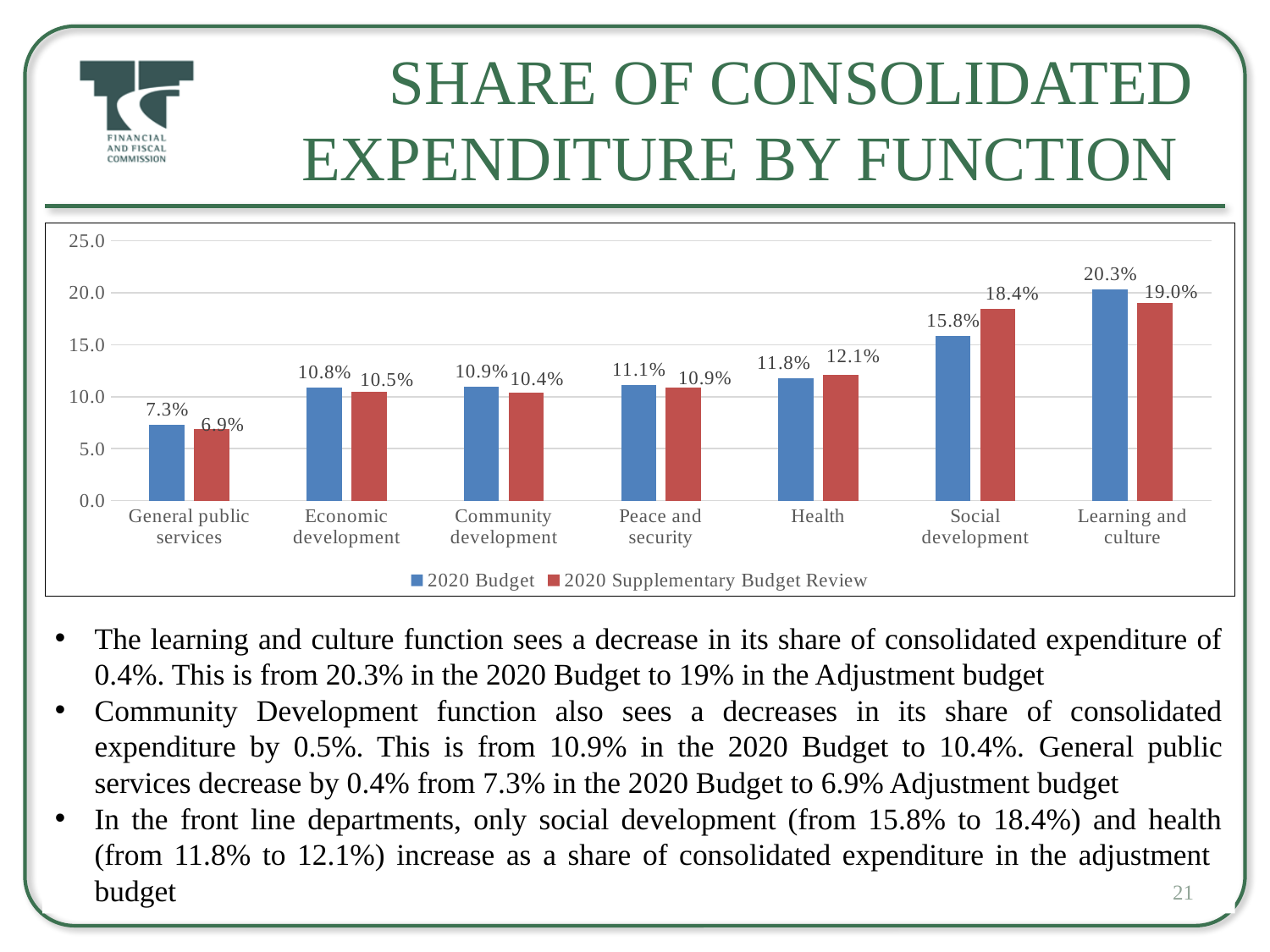
Which category has the highest 2020 Budget value? Learning and culture Which series is shown in red in the legend? 2020 Supplementary Budget Review How many series does the legend list? 2 What is the difference between the 2020 Budget and 2020 Supplementary Budget Review values for Social development? 2.6% How many categories are shown on the x axis? 7 What kind of chart is shown on the slide? Bar chart Which is larger for Health: the 2020 Budget value or the 2020 Supplementary Budget Review value? 2020 Supplementary Budget Review What is the 2020 Budget value for General public services? 7.3% What is the 2020 Supplementary Budget Review value for Social development? 18.4% Which category has the lowest 2020 Supplementary Budget Review value? General public services What is the 2020 Budget value for Health? 11.8% Is the 2020 Budget value for Social development greater or less than 15.0? greater